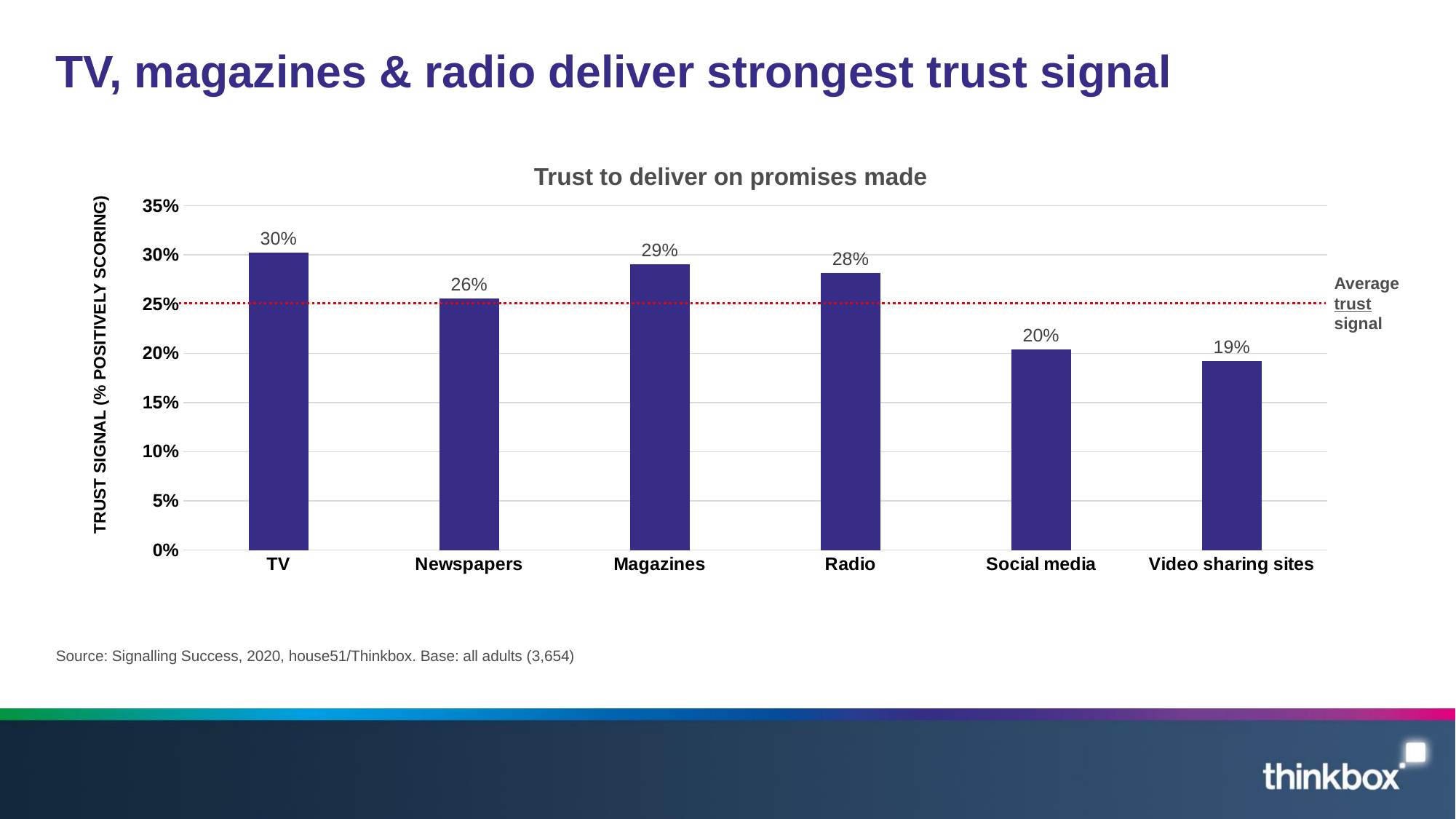
What is the difference between the trust signal for Magazines and for Social media? 9% Which category has the lowest trust signal? Video sharing sites What kind of chart is shown on the slide? Bar chart Which category has the highest trust signal? TV How many categories are shown on the x axis? 6 What is the trust signal value for Newspapers? 26% What is the trust signal value for Social media? 20% Is the value for Social media greater or less than 25%? less What is the difference between the trust signal for TV and for Video sharing sites? 11% What is the title of the chart? Trust to deliver on promises made What is the trust signal value for TV? 30% Which has a higher trust signal, Radio or Newspapers? Radio